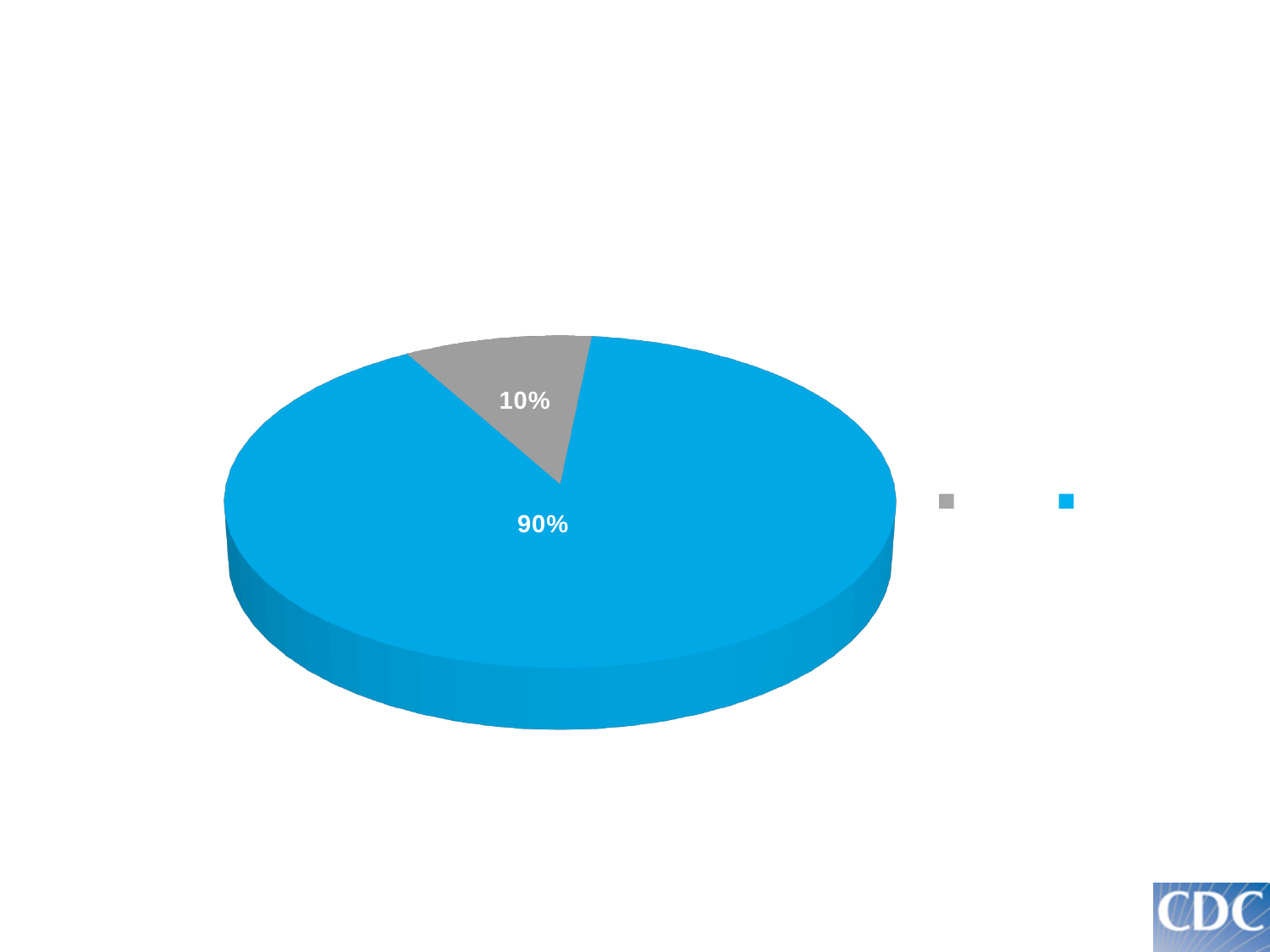
What share of the pie does the gray slice represent? 10% By how many percentage points does the blue slice exceed the gray slice? 80 percentage points Which slice of the pie chart is the largest? the blue slice (90%) How many entries does the legend of the pie chart show? 2 Which is larger in the pie chart, the blue slice or the gray slice? the blue slice Which slice of the pie chart is the smallest? the gray slice (10%) What kind of chart is shown on the slide? pie chart What percentage is shown for the blue slice of the pie chart? 90% What percentage is shown for the gray slice of the pie chart? 10% How many slices does the pie chart have? 2 What colour is the slice labelled 90%? blue What colour is the slice labelled 10%? gray